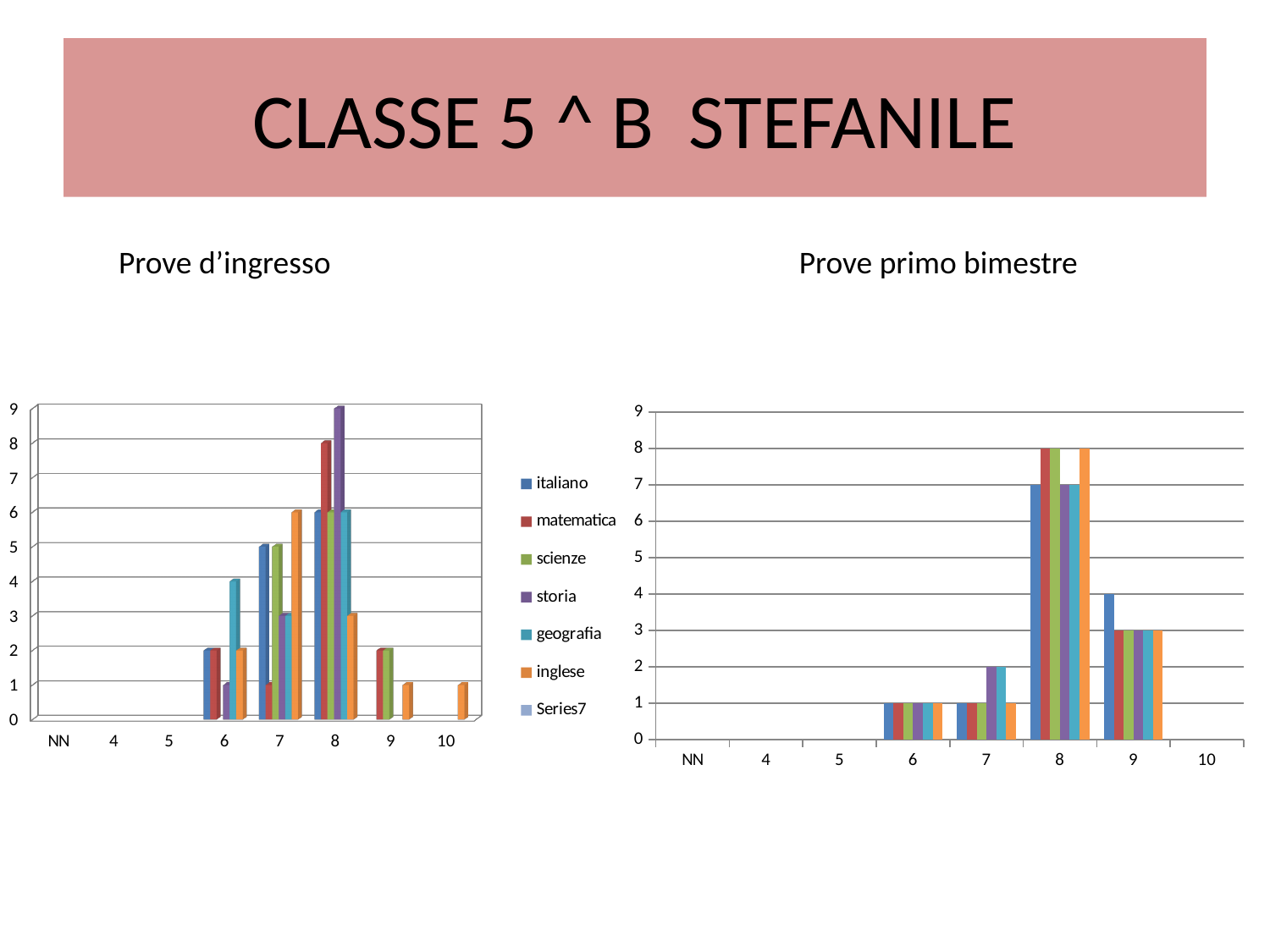
In the 'Prove primo bimestre' chart, which category has the tallest bars? 8 In the 'Prove primo bimestre' chart, what is the difference between italiano and matematica at category 9? 1 What kind of chart is the 'Prove primo bimestre' chart? bar chart How many series does the legend on the slide list? 7 In the 'Prove primo bimestre' chart, what is the value for matematica at category 8? 8 How many categories are shown on the x axis of the 'Prove primo bimestre' chart? 8 In the 'Prove primo bimestre' chart, what is the value for storia at category 7? 2 In the 'Prove d'ingresso' chart, is the value for inglese at category 7 greater or less than 5? greater What is the title of the chart on the left of the slide? Prove d'ingresso In the 'Prove d'ingresso' chart, which series has the tallest bar at category 8? storia In the 'Prove primo bimestre' chart, what is the value for italiano at category 9? 4 In the 'Prove primo bimestre' chart, at category 9, which is larger: italiano or matematica? italiano